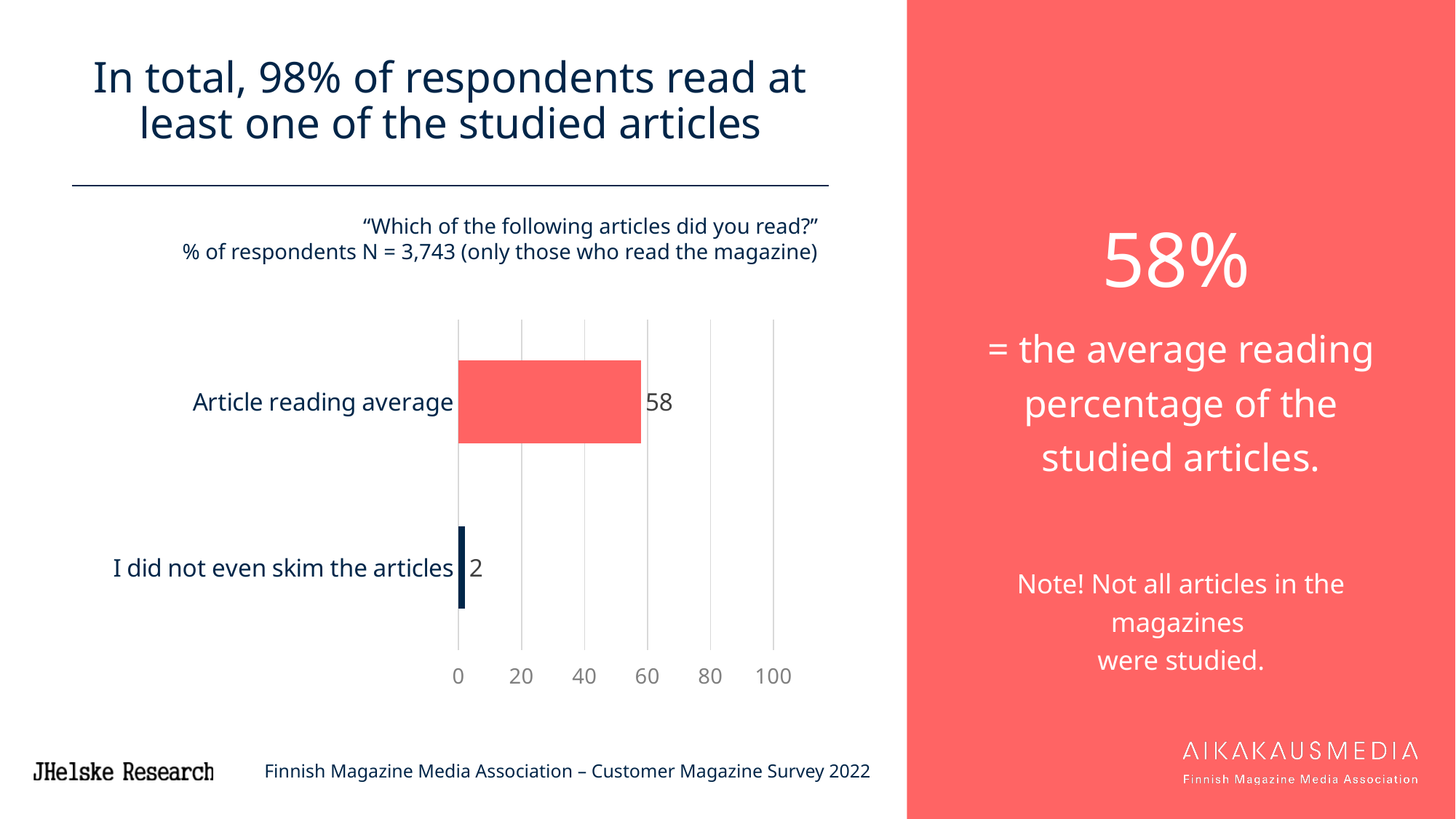
What is the sample size (N) stated in the chart subtitle? 3,743 How many categories are shown in the chart? 2 Is the value for "Article reading average" greater or less than 40? greater What is the value for "Article reading average"? 58 What is the value for "I did not even skim the articles"? 2 Which category has the lowest value? I did not even skim the articles Which category has the highest value? Article reading average What is the difference between the values for "Article reading average" and "I did not even skim the articles"? 56 What is the highest tick value shown on the chart's axis? 100 Is the value for "I did not even skim the articles" greater or less than 20? less What kind of chart is shown on the slide? bar chart Which is larger: the value for "Article reading average" or for "I did not even skim the articles"? Article reading average